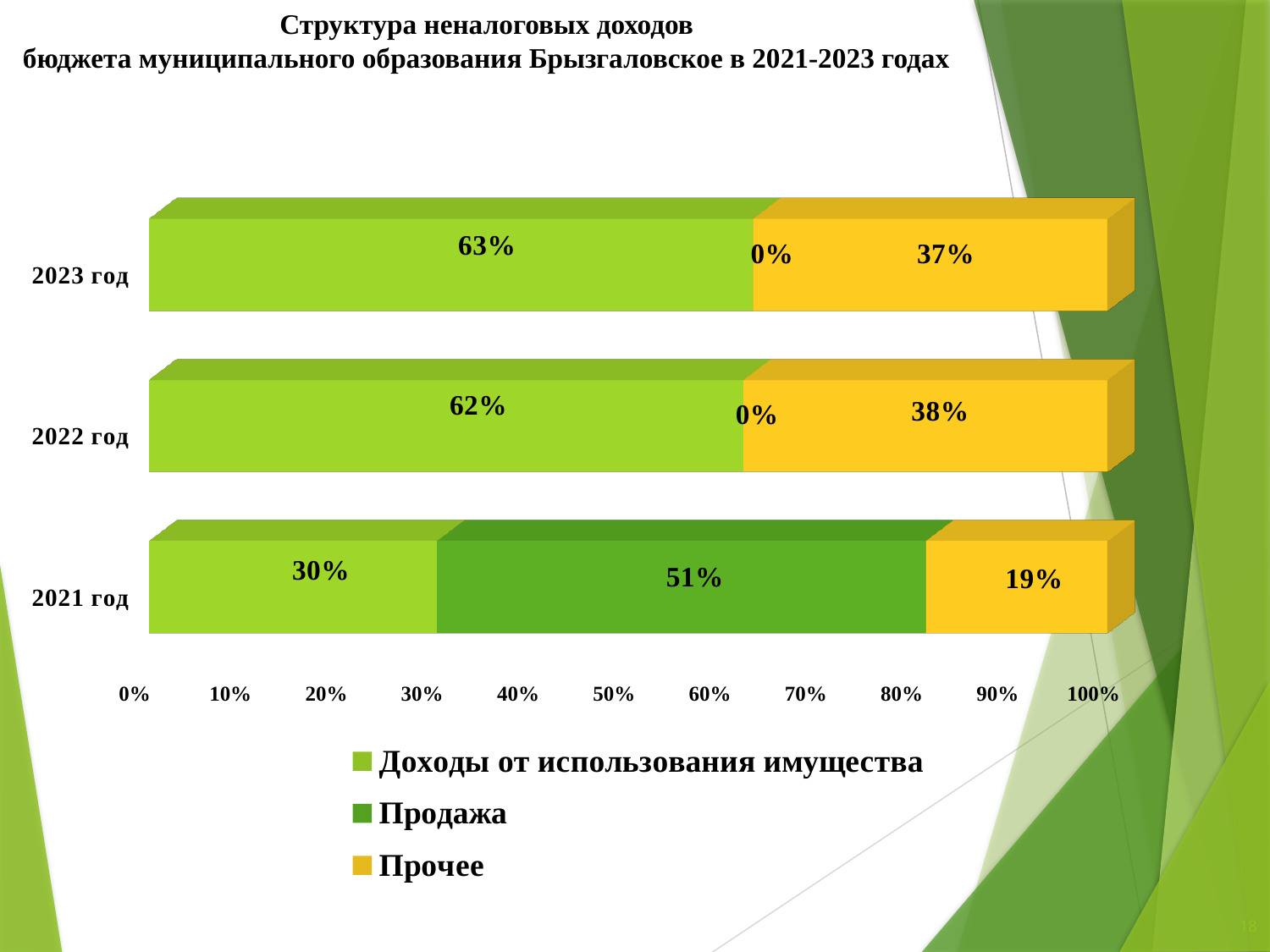
Which series is shown in yellow in the legend? Прочее In which year is the share of 'Прочее' the highest? 2022 год What is the share of 'Продажа' in 2021 год? 51% Which is larger in 2021 год: the share of 'Продажа' or the share of 'Доходы от использования имущества'? Продажа How many years (categories) are shown on the chart? 3 What kind of chart is shown on the slide? Stacked bar chart What is the share of 'Доходы от использования имущества' in 2023 год? 63% In which year is the share of 'Доходы от использования имущества' the lowest? 2021 год How many series does the legend list? 3 What is the difference between the 'Прочее' share in 2022 год and in 2021 год? 19% What is the share of 'Продажа' in 2023 год? 0% What is the share of 'Прочее' in 2022 год? 38%